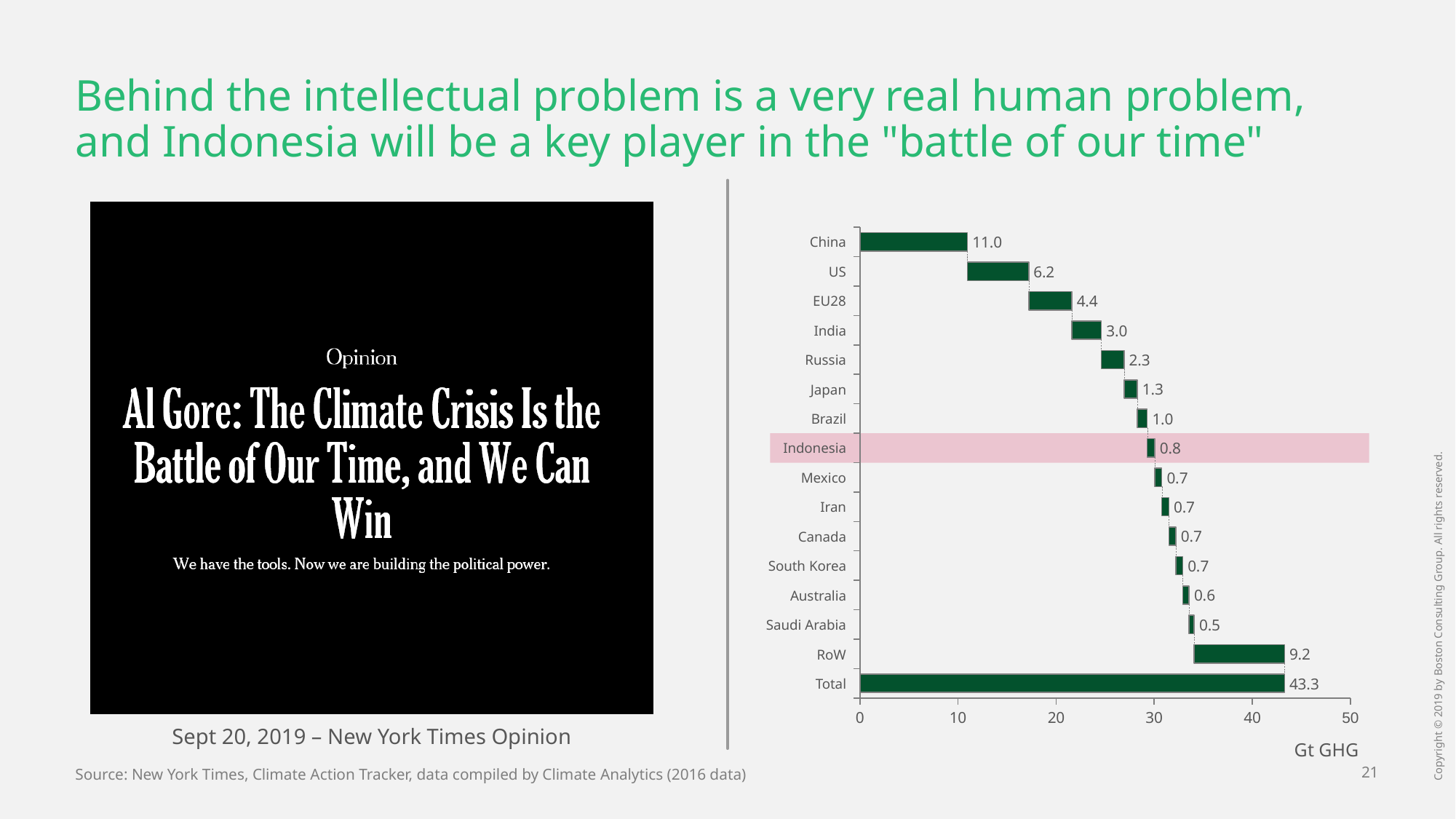
What is the value for RoW in the chart? 9.2 Which category has the lowest value in the chart? Saudi Arabia Which category row is highlighted in pink on the chart? Indonesia How many categories (including Total) are listed on the chart's vertical axis? 16 What is the Total value shown at the bottom of the chart? 43.3 Which has a larger value, India or Russia? India What type of chart is shown on the right side of the slide? Bar chart (waterfall) What unit is shown below the chart's horizontal axis? Gt GHG What is the value for China in the chart? 11.0 What is the value for Indonesia in the chart? 0.8 What is the difference between the values for China and the US? 4.8 Excluding the Total bar, which country or region has the highest value in the chart? China